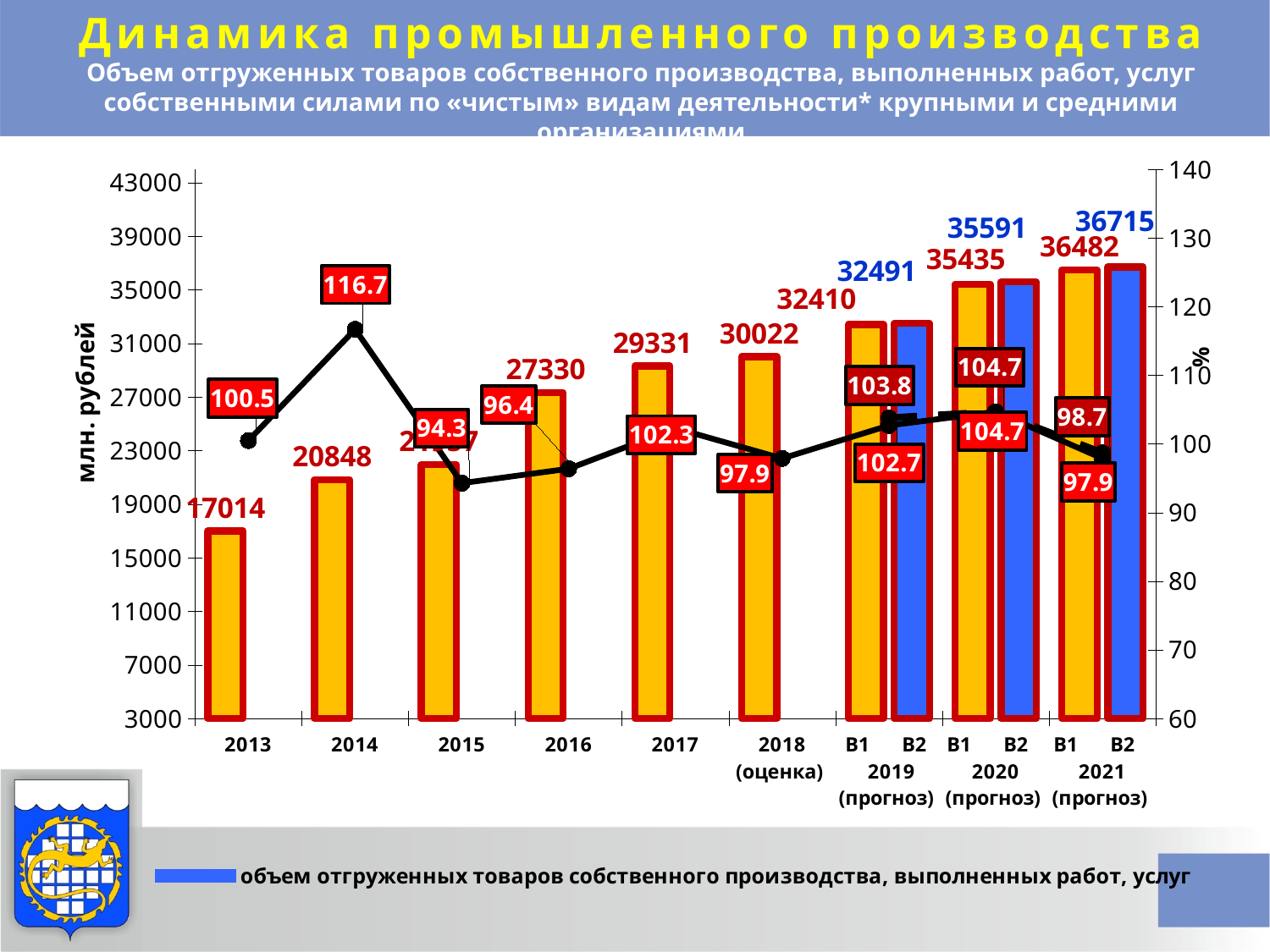
What is the value of the bar for 2018 (оценка)? 30022 Which bar has the lowest value? 2013 What percentage value does the line show for 2014? 116.7 What is the value of the B2 bar for 2021 (прогноз)? 36715 What is the difference between the bar values for 2014 and 2013? 3834 What is the value of the bar for 2017? 29331 Which bar has the highest value? B2 2021 (прогноз) What is the value of the bar for 2013? 17014 Which bar is larger, 2016 or 2017? 2017 Is the value of the bar for 2015 greater or less than 19000? greater What is the label of the left vertical axis? млн. рублей What is the difference between the B2 and B1 bar values for 2021 (прогноз)? 233